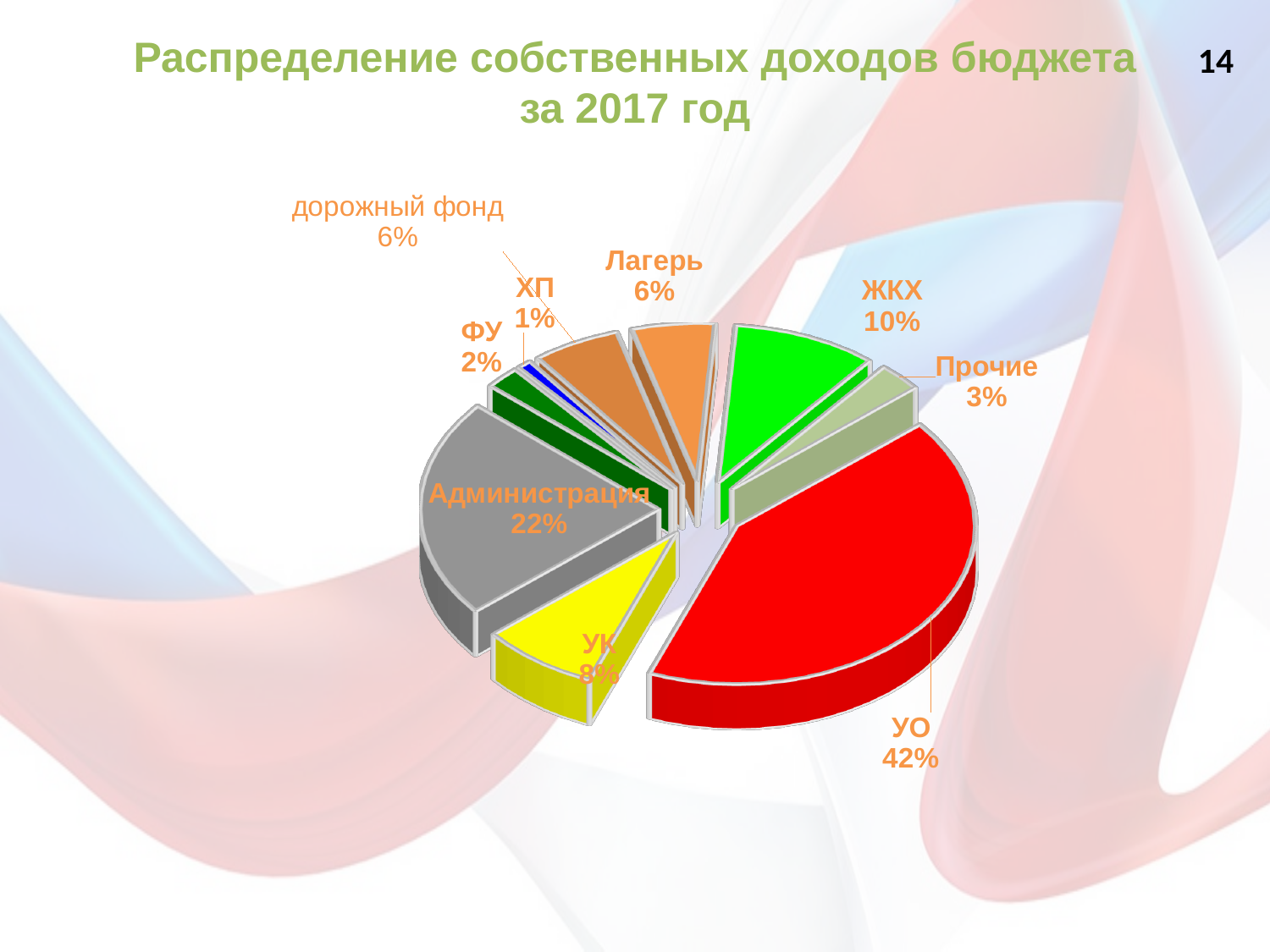
Which category has the largest share of the pie? УО What is the difference in percentage points between УО and Администрация? 20 Which is larger, the share for УК or the share for ЖКХ? ЖКХ How many slices does the pie chart have? 9 What share of the pie does ЖКХ have? 10% What is the title of the chart on the slide? Распределение собственных доходов бюджета за 2017 год What share of the pie does ХП have? 1% What share of the pie does дорожный фонд have? 6% What share of the pie does УО have? 42% What kind of chart is shown on the slide? Pie chart Which category has the smallest share of the pie? ХП What share of the pie does Администрация have? 22%